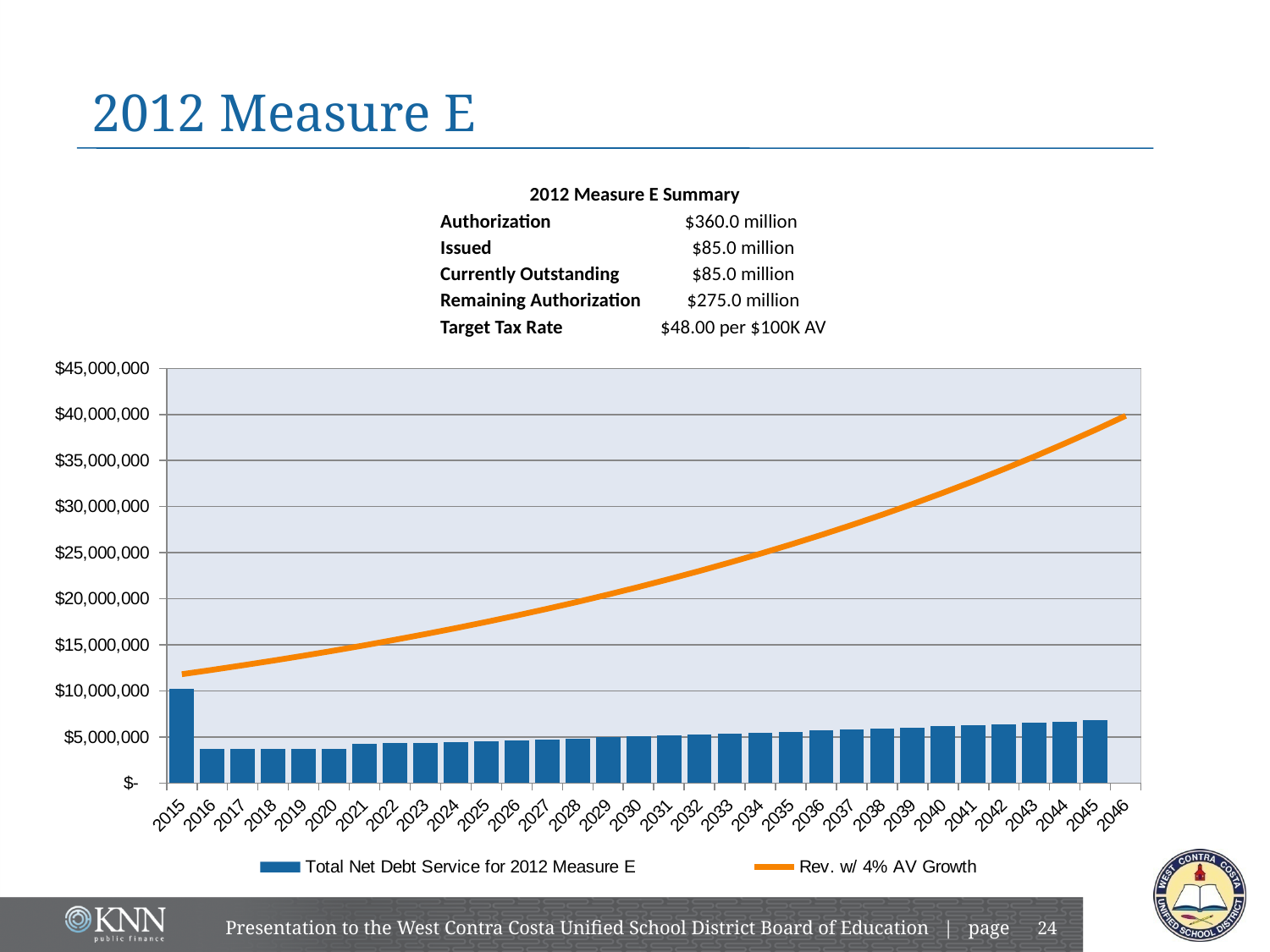
Does the Rev. w/ 4% AV Growth line rise or fall from 2015 to 2046? rise What kind of chart is shown on the slide? A bar chart combined with a line chart Is the Rev. w/ 4% AV Growth value for 2046 greater or less than $35,000,000? greater Is the Total Net Debt Service bar for 2015 greater or less than $5,000,000? greater Which year has the highest Total Net Debt Service bar? 2015 In 2030, which is larger: the Total Net Debt Service bar or the Rev. w/ 4% AV Growth line? Rev. w/ 4% AV Growth What are the two series named in the chart legend? Total Net Debt Service for 2012 Measure E; Rev. w/ 4% AV Growth Which is larger: the Total Net Debt Service bar for 2015 or for 2045? 2015 Is the Total Net Debt Service bar for 2045 greater or less than $5,000,000? greater How many series does the chart legend list? 2